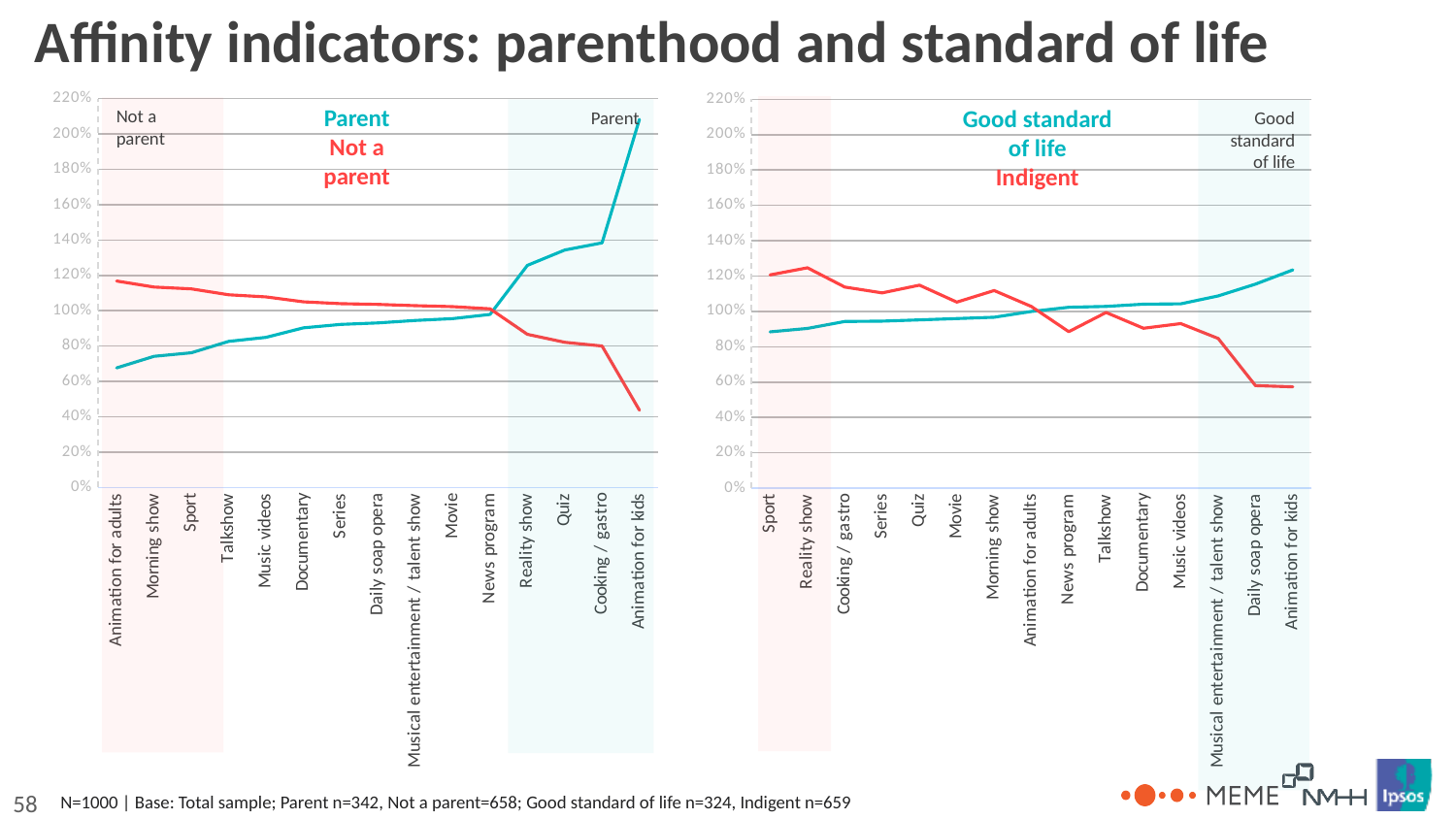
In the left chart (Parent / Not a parent), is the Parent value for Animation for kids greater or less than 180%? greater In the right chart (Good standard of life / Indigent), for which category is the Good standard of life series highest? Animation for kids In the left chart (Parent / Not a parent), which series has the larger value for Sport, Parent or Not a parent? Not a parent In the left chart (Parent / Not a parent), is the Not a parent value for Animation for kids greater or less than 60%? less In the right chart (Good standard of life / Indigent), is the Indigent value for Animation for kids greater or less than 80%? less In the right chart (Good standard of life / Indigent), does the Indigent series generally rise or fall from left to right along the x axis? fall In the left chart (Parent / Not a parent), for which category is the Parent series highest? Animation for kids How many series does the legend of the right chart (Good standard of life / Indigent) show? 2 How many categories are plotted on the x axis of the left chart (Parent / Not a parent)? 15 What type of chart is the left chart (Parent / Not a parent)? line chart In the left chart (Parent / Not a parent), for which category is the Parent series lowest? Animation for adults In the left chart (Parent / Not a parent), for which category is the Not a parent series highest? Animation for adults